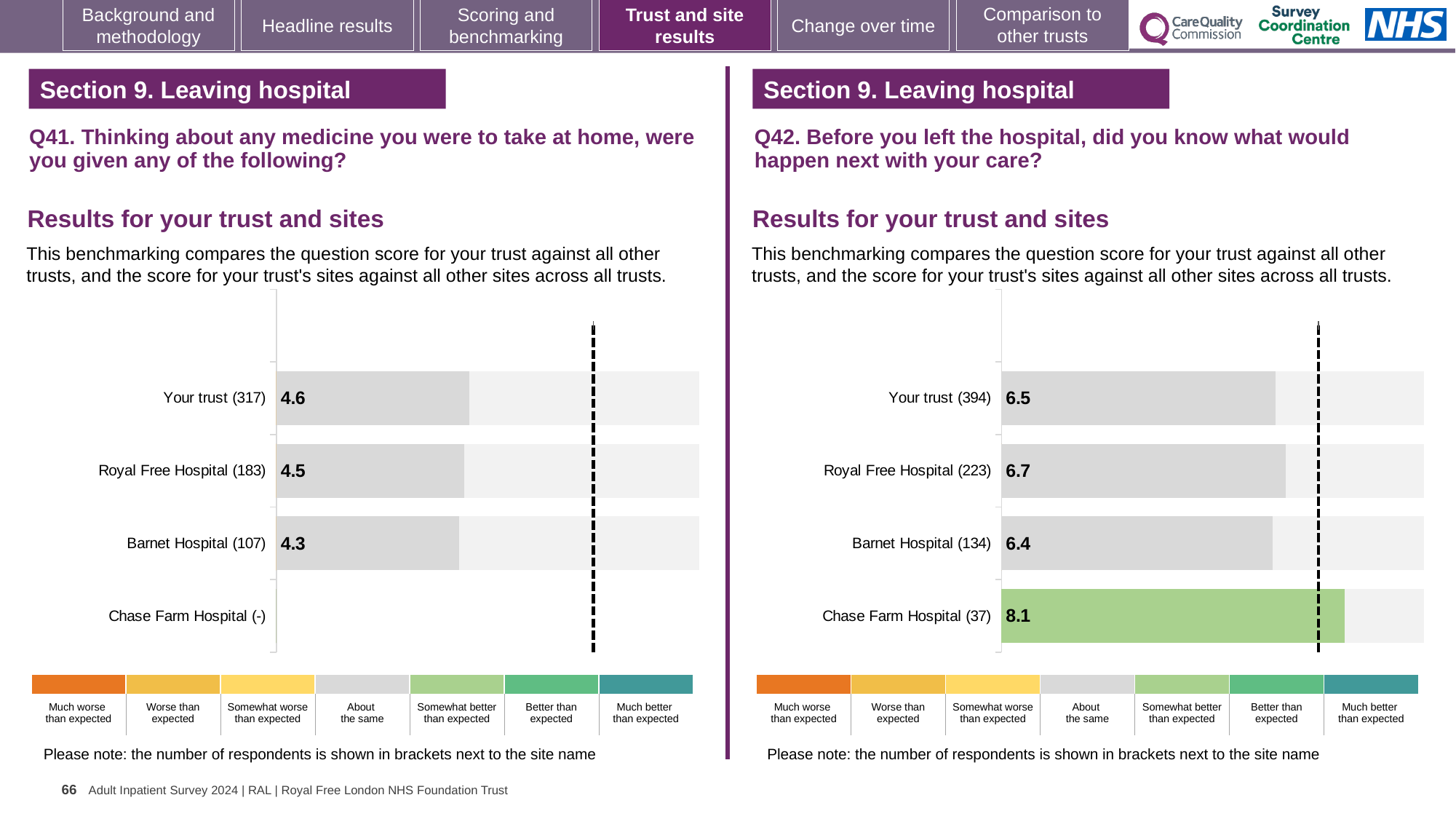
On the Q41 chart (left), what is the difference between the scores for Your trust and Barnet Hospital? 0.3 On the Q41 chart (left), what is the score for Your trust? 4.6 On the Q41 chart (left), what is the score for Barnet Hospital? 4.3 On the Q41 chart (left), which has a higher score, Royal Free Hospital or Barnet Hospital? Royal Free Hospital On the Q42 chart (right), how many respondents are shown for Chase Farm Hospital? 37 What type of chart is used on the Q42 chart (right)? Bar chart On the Q42 chart (right), which site has the highest score? Chase Farm Hospital On the Q42 chart (right), what is the difference between the scores for Chase Farm Hospital and Your trust? 1.6 On the Q42 chart (right), what is the score for Royal Free Hospital? 6.7 On the Q42 chart (right), what is the score for Chase Farm Hospital? 8.1 On the Q41 chart (left), how many site rows are listed, including Your trust? 4 On the Q42 chart (right), which site has the lowest score? Barnet Hospital